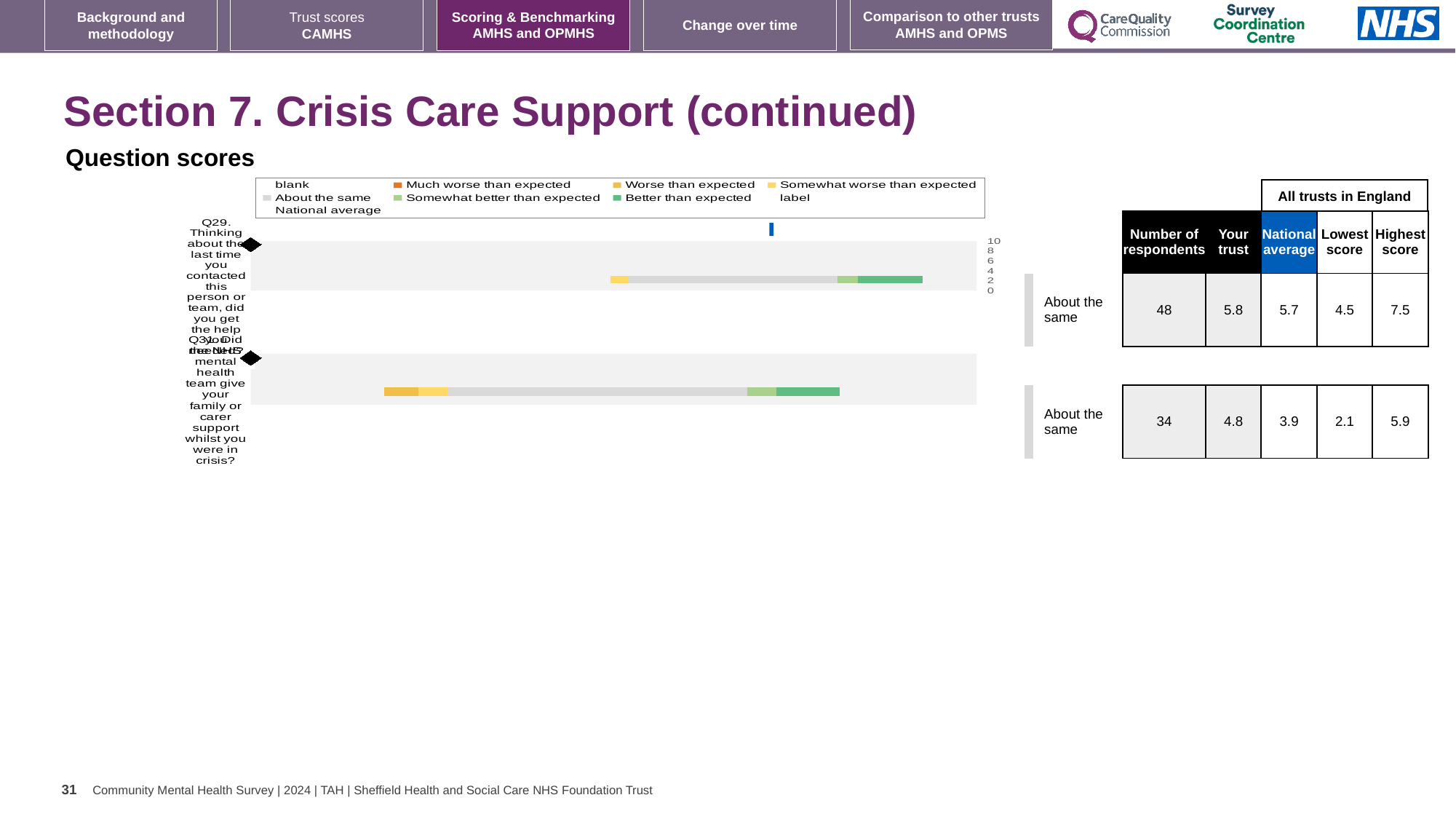
What is the 'Your trust' score for Q29? 5.8 What kind of chart is shown under 'Question scores'? bar chart What is the difference between the 'Your trust' score and the national average for Q31? 0.9 Which legend entry is shown in grey? About the same What is the lowest score across all trusts in England for Q31? 2.1 Which legend entry is shown in orange? Much worse than expected How many question rows (categories) are plotted in the chart? 2 What is the highest score across all trusts in England for Q29? 7.5 What is the national average for Q31? 3.9 Which question has the larger 'Your trust' score, Q29 or Q31? Q29 How many entries does the chart legend list? 9 What is the 'Your trust' score for Q31? 4.8